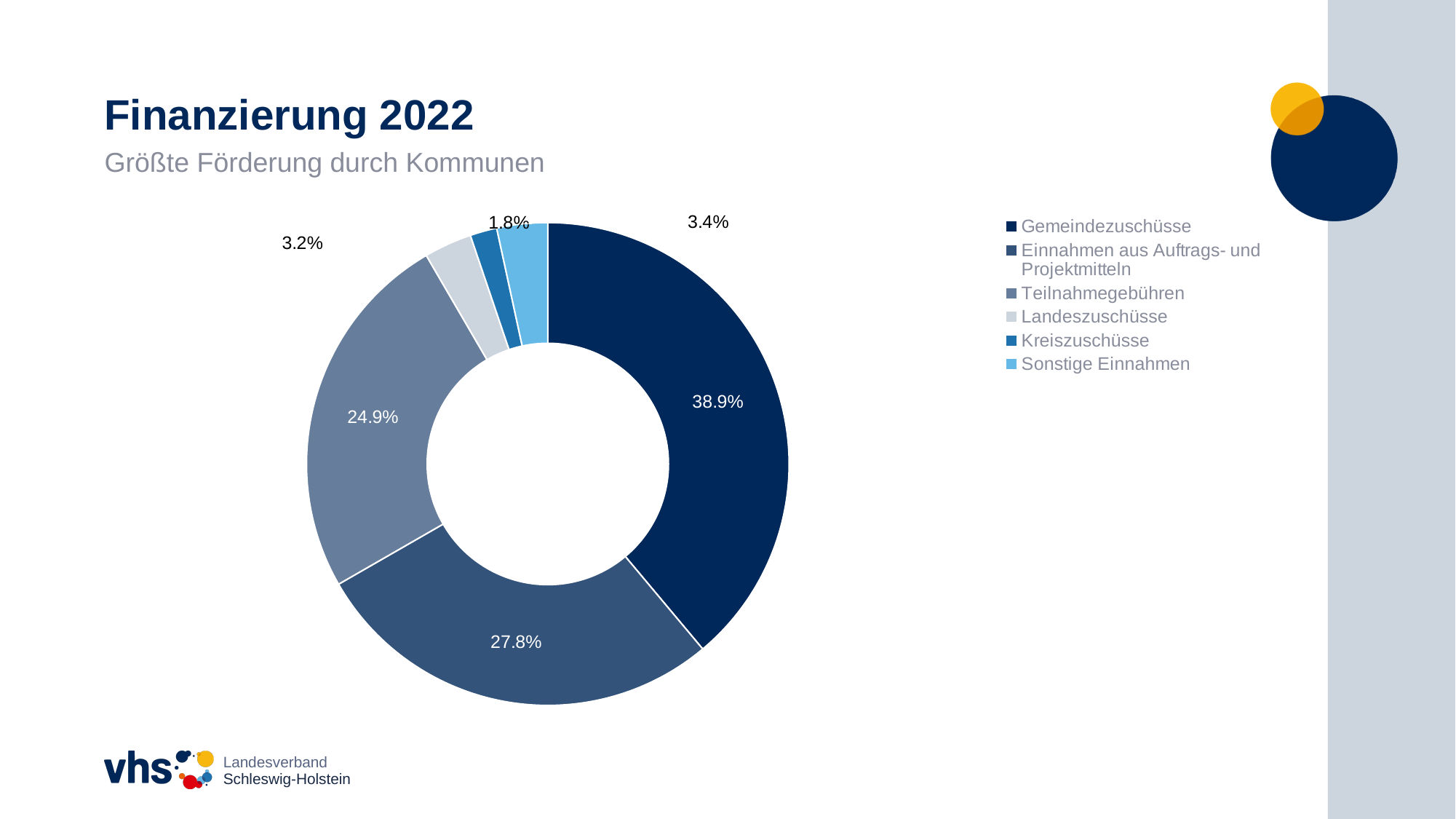
What is the title of the slide containing the chart? Finanzierung 2022 What share of the pie does Gemeindezuschüsse have? 38.9% Which is larger, Landeszuschüsse or Sonstige Einnahmen? Sonstige Einnahmen What share of the pie does Kreiszuschüsse have? 1.8% What is the combined share of Landeszuschüsse and Kreiszuschüsse? 5.0% What share of the pie does Teilnahmegebühren have? 24.9% What share of the pie does Einnahmen aus Auftrags- und Projektmitteln have? 27.8% How many categories does the pie chart show? 6 Which category has the smallest share of the pie? Kreiszuschüsse What kind of chart is shown on the slide? Doughnut chart What is the difference in percentage points between Gemeindezuschüsse and Teilnahmegebühren? 14.0 Which category has the largest share of the pie? Gemeindezuschüsse